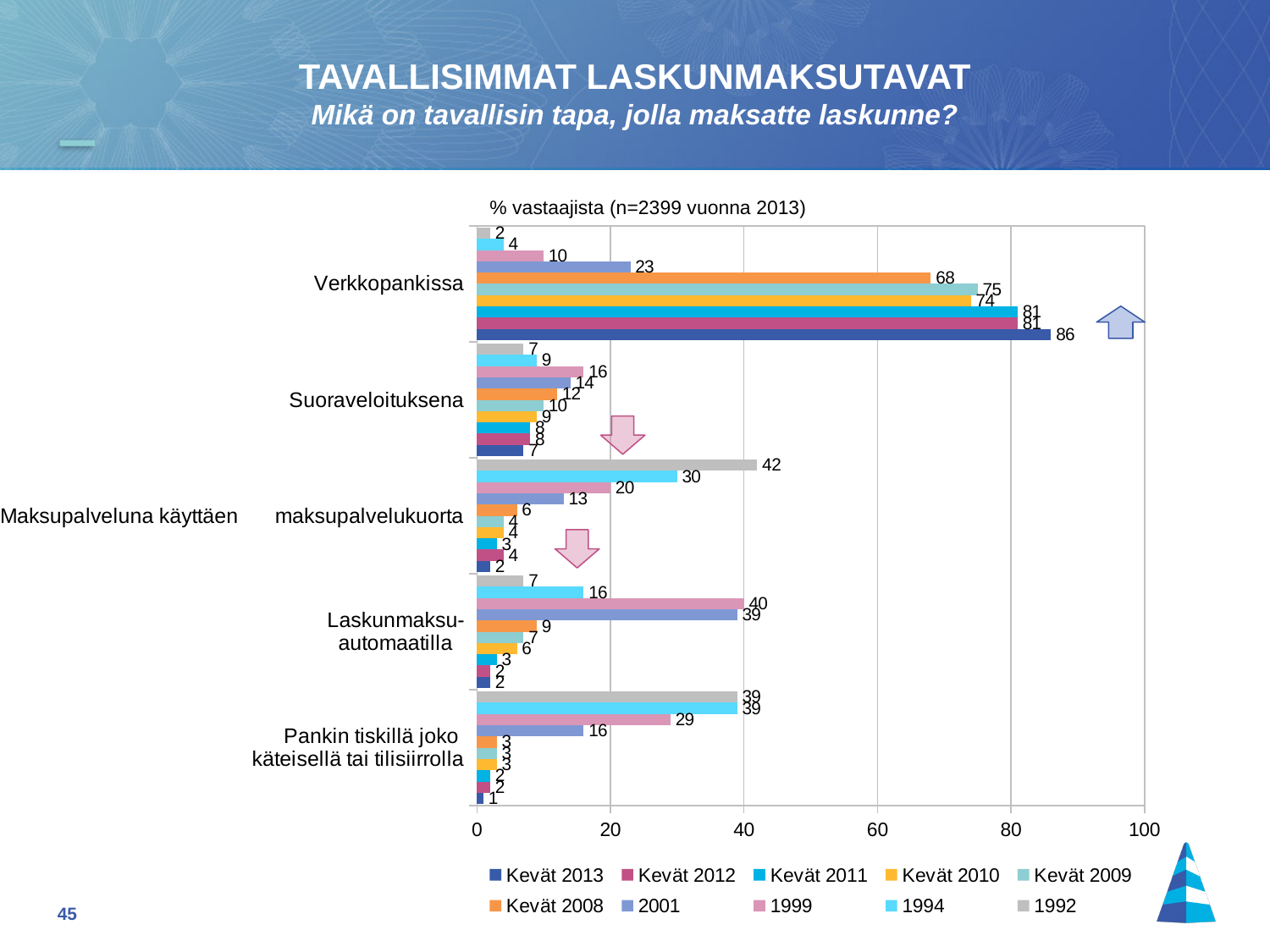
What is the value for Verkkopankissa in Kevät 2008? 68 What kind of chart is shown on the slide? bar chart What is the difference between the Verkkopankissa values for Kevät 2013 and 2001? 63 Which category has the highest value in Kevät 2013? Verkkopankissa Which is larger for Pankin tiskillä joko käteisellä tai tilisiirrolla: the 1999 value or the 2001 value? 1999 What is the value for Verkkopankissa in Kevät 2013? 86 Which category has the lowest value in Kevät 2013? Pankin tiskillä joko käteisellä tai tilisiirrolla Does the value for Verkkopankissa rise or fall from 1992 to Kevät 2013? rise What is the value for maksupalvelukuorta in 1992? 42 How many series does the legend list? 10 What is the value for Laskunmaksuautomaatilla in 1999? 40 How many payment-method categories are shown on the chart? 5